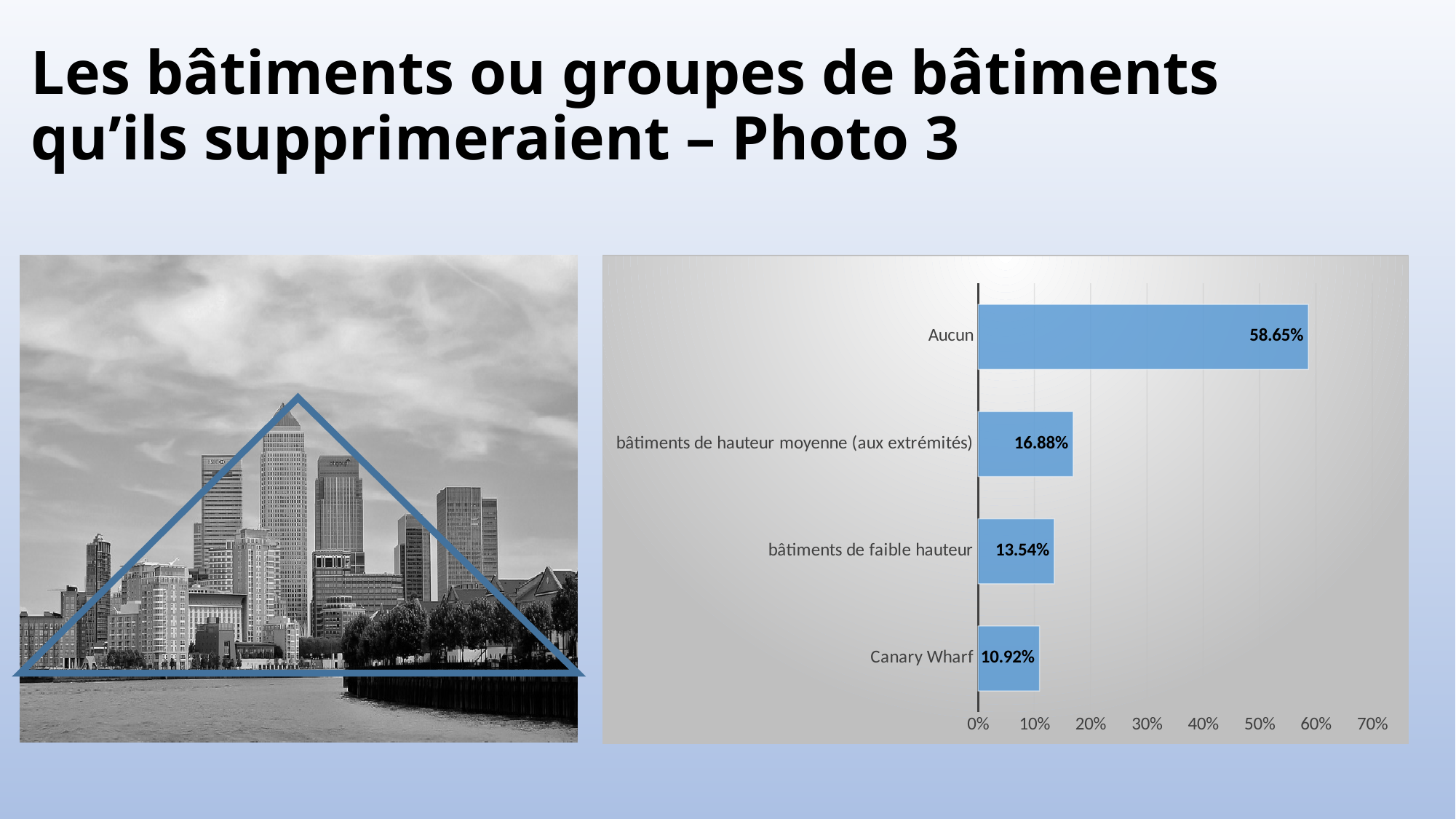
What kind of chart is shown on the slide? bar chart What is the difference between the values for bâtiments de hauteur moyenne (aux extrémités) and bâtiments de faible hauteur? 3.34% How many categories are shown in the chart? 4 What is the value for Aucun? 58.65% What is the value for bâtiments de hauteur moyenne (aux extrémités)? 16.88% Which is larger, the value for bâtiments de faible hauteur or the value for Canary Wharf? bâtiments de faible hauteur What is the value for bâtiments de faible hauteur? 13.54% What is the value for Canary Wharf? 10.92% What is the difference between the values for Aucun and Canary Wharf? 47.73% Which category has the highest value? Aucun Which category has the lowest value? Canary Wharf Is the value for Aucun greater or less than 50%? greater